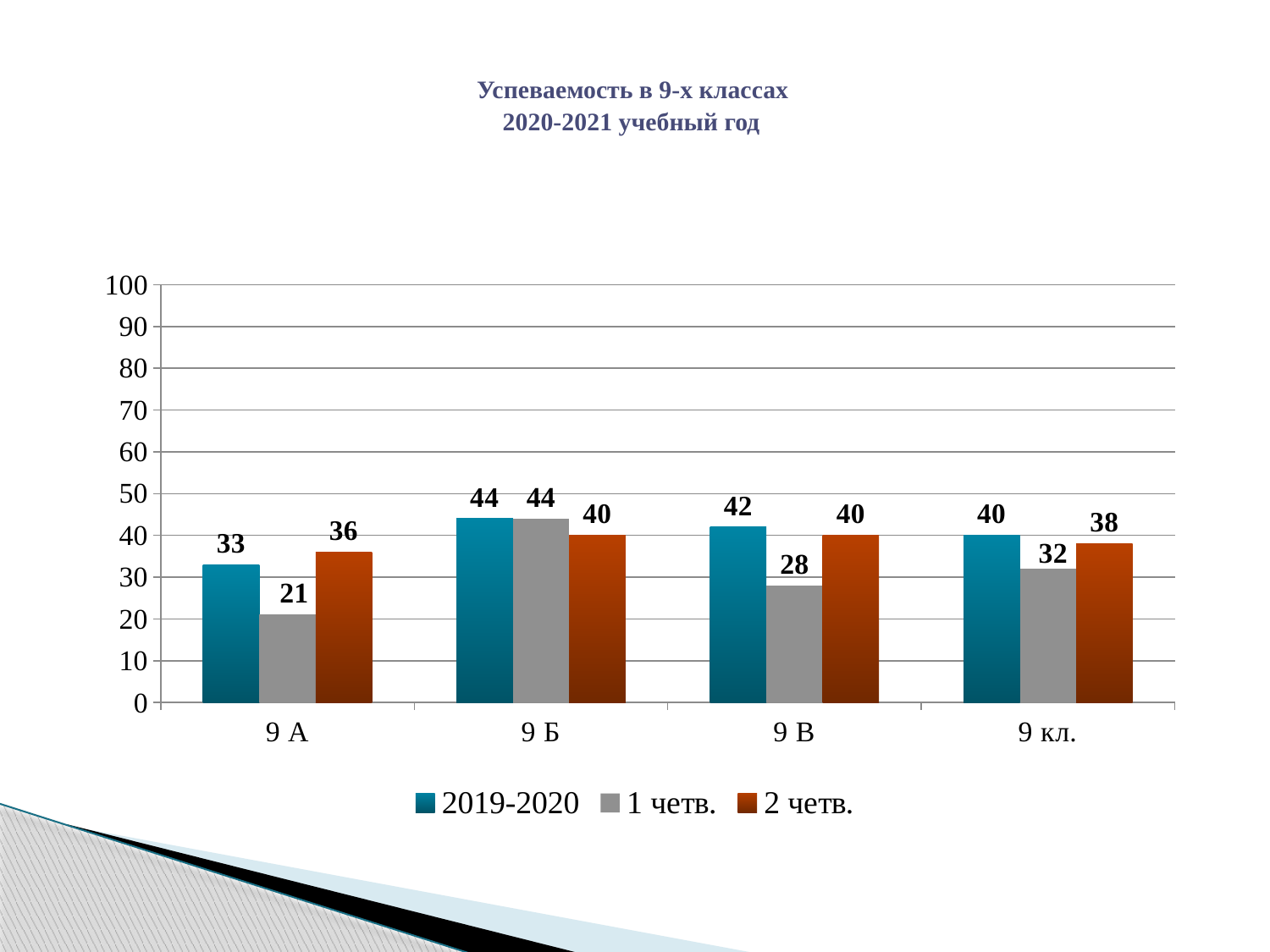
What is the title of the slide? Успеваемость в 9-х классах 2020-2021 учебный год How many series does the legend list? 3 What is the difference between the 2 четв. and 1 четв. values for 9 В? 12 What kind of chart is shown on the slide? bar chart Which category has the lowest value in the 1 четв. series? 9 А Which category has the highest value in the 2019-2020 series? 9 Б Is the value for 9 Б in the 2 четв. series greater or less than 50? less Which is larger for 9 А: the 2019-2020 value or the 2 четв. value? 2 четв. What is the value for 9 А in the 1 четв. series? 21 What is the value for 9 кл. in the 2 четв. series? 38 How many categories are shown on the x axis? 4 What is the value for 9 Б in the 2019-2020 series? 44